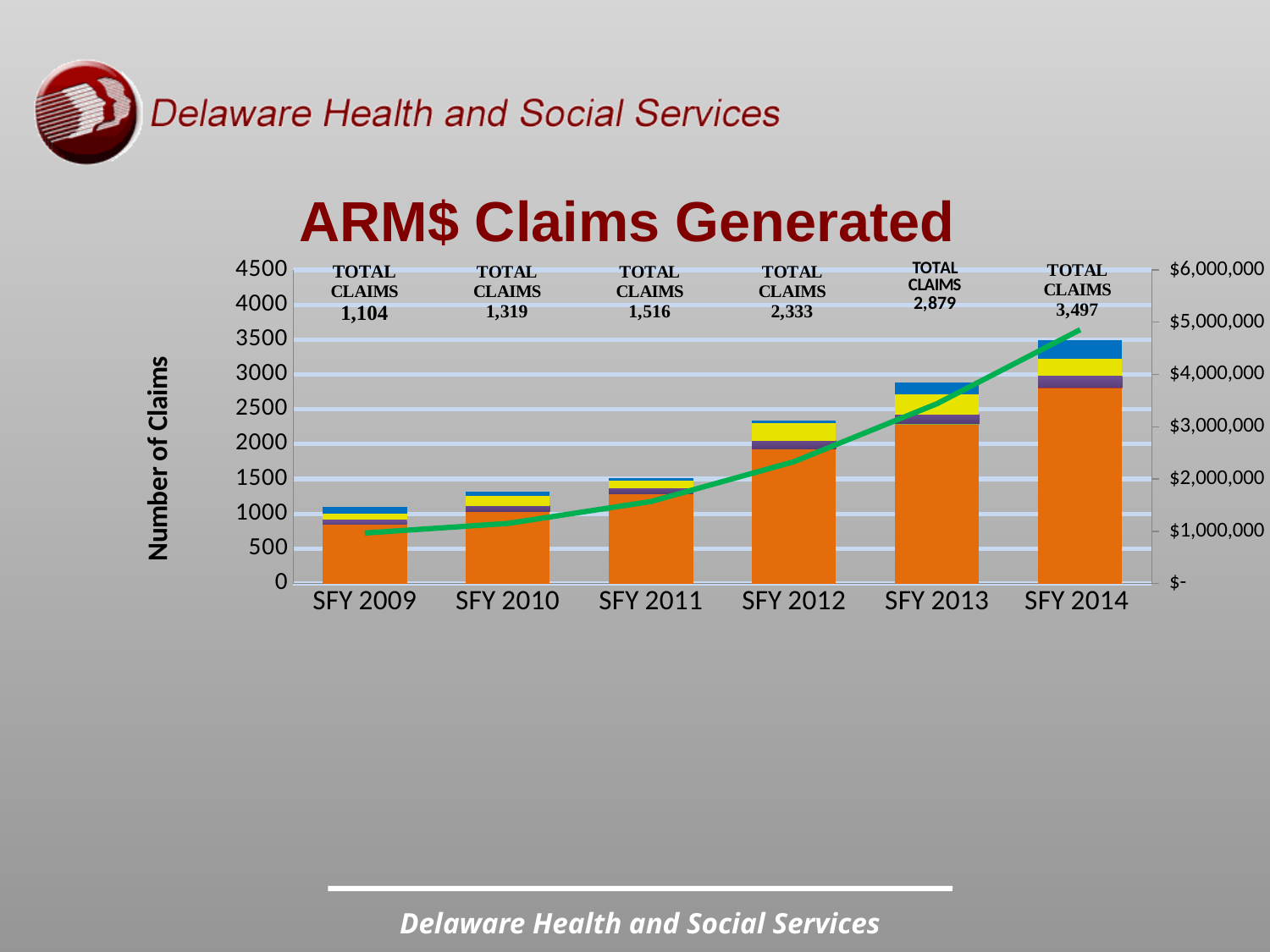
What is the difference in total claims between SFY 2014 and SFY 2013? 618 What is the title of the chart? ARM$ Claims Generated What is the total claims value shown for SFY 2014? 3,497 How many fiscal years are shown on the x axis? 6 Which has more total claims, SFY 2010 or SFY 2011? SFY 2011 What is the difference in total claims between SFY 2012 and SFY 2011? 817 Is the value of the green line for SFY 2014 greater or less than $4,000,000 on the right axis? greater Which fiscal year has the lowest total claims? SFY 2009 Do the total claims rise or fall from SFY 2009 to SFY 2014? rise What is the total claims value shown for SFY 2009? 1,104 What is the total claims value shown for SFY 2012? 2,333 Which fiscal year has the highest total claims? SFY 2014